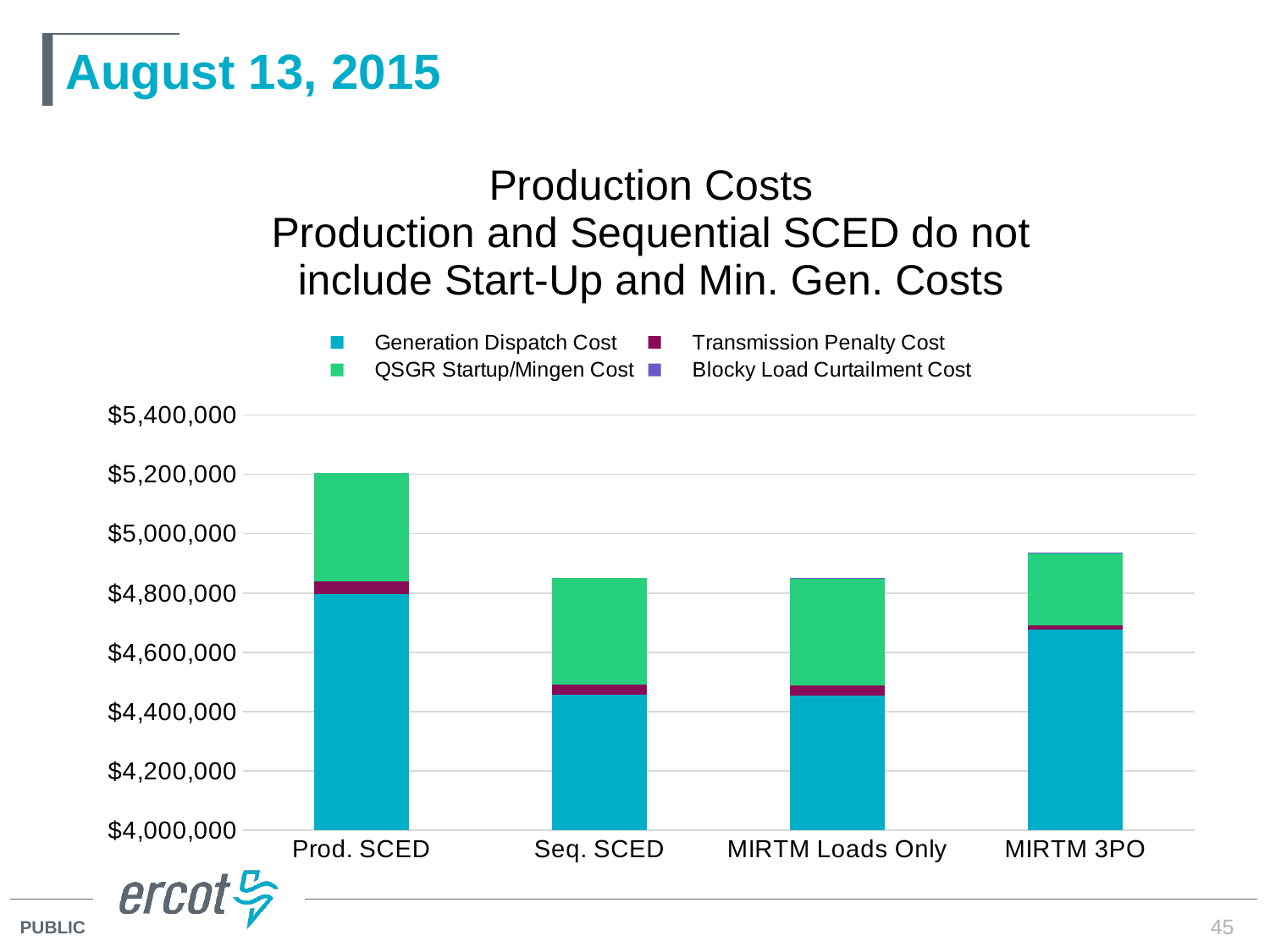
Is the total production cost for MIRTM 3PO greater or less than $5,000,000? less Which has a higher total production cost, Prod. SCED or MIRTM 3PO? Prod. SCED How many categories are shown on the x axis of the chart? 4 How many series does the chart's legend list? 4 Which legend entry is shown in green? QSGR Startup/Mingen Cost Is the total production cost for Prod. SCED greater or less than $5,000,000? greater Is the total production cost for Seq. SCED greater or less than $5,000,000? less What kind of chart is shown on the slide? Stacked bar chart Which category has the highest total production cost? Prod. SCED Which has a higher total production cost, MIRTM 3PO or Seq. SCED? MIRTM 3PO